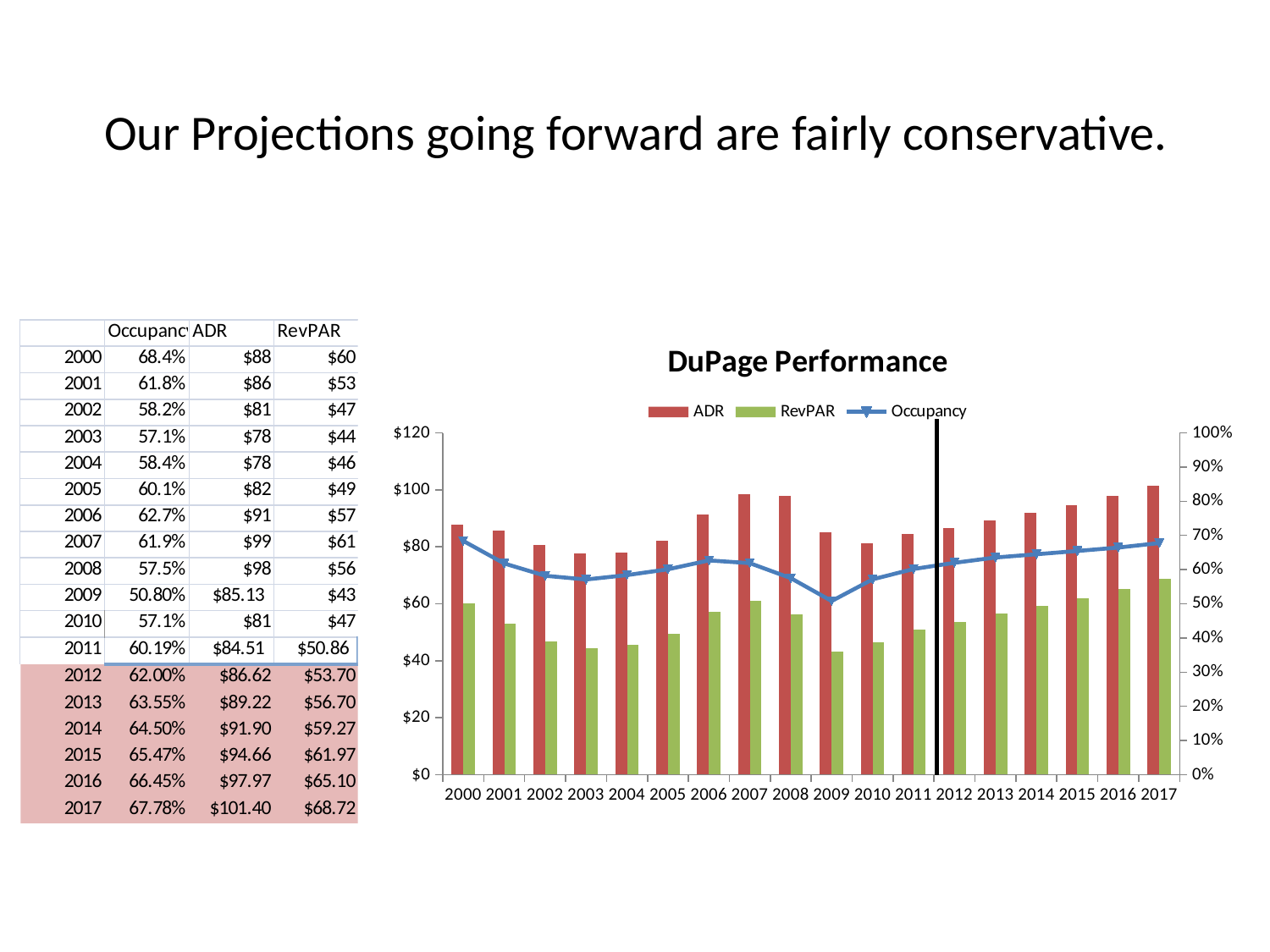
What is the ADR value for 2017 according to the table on the slide? $101.40 In which year is Occupancy lowest in the DuPage Performance chart? 2009 Which series in the DuPage Performance chart is plotted as a line? Occupancy In which year is ADR highest in the DuPage Performance chart? 2017 Do ADR values rise or fall from 2012 to 2017 in the DuPage Performance chart? rise How many years are shown on the x axis of the DuPage Performance chart? 18 In which year is RevPAR highest in the DuPage Performance chart? 2017 Is the Occupancy value for 2009 greater or less than 60%? less Is the ADR value for 2007 greater or less than $80? greater Is ADR in 2008 larger than ADR in 2009? Yes How many series does the legend of the DuPage Performance chart list? 3 What kind of chart is the DuPage Performance chart? A combined bar and line chart